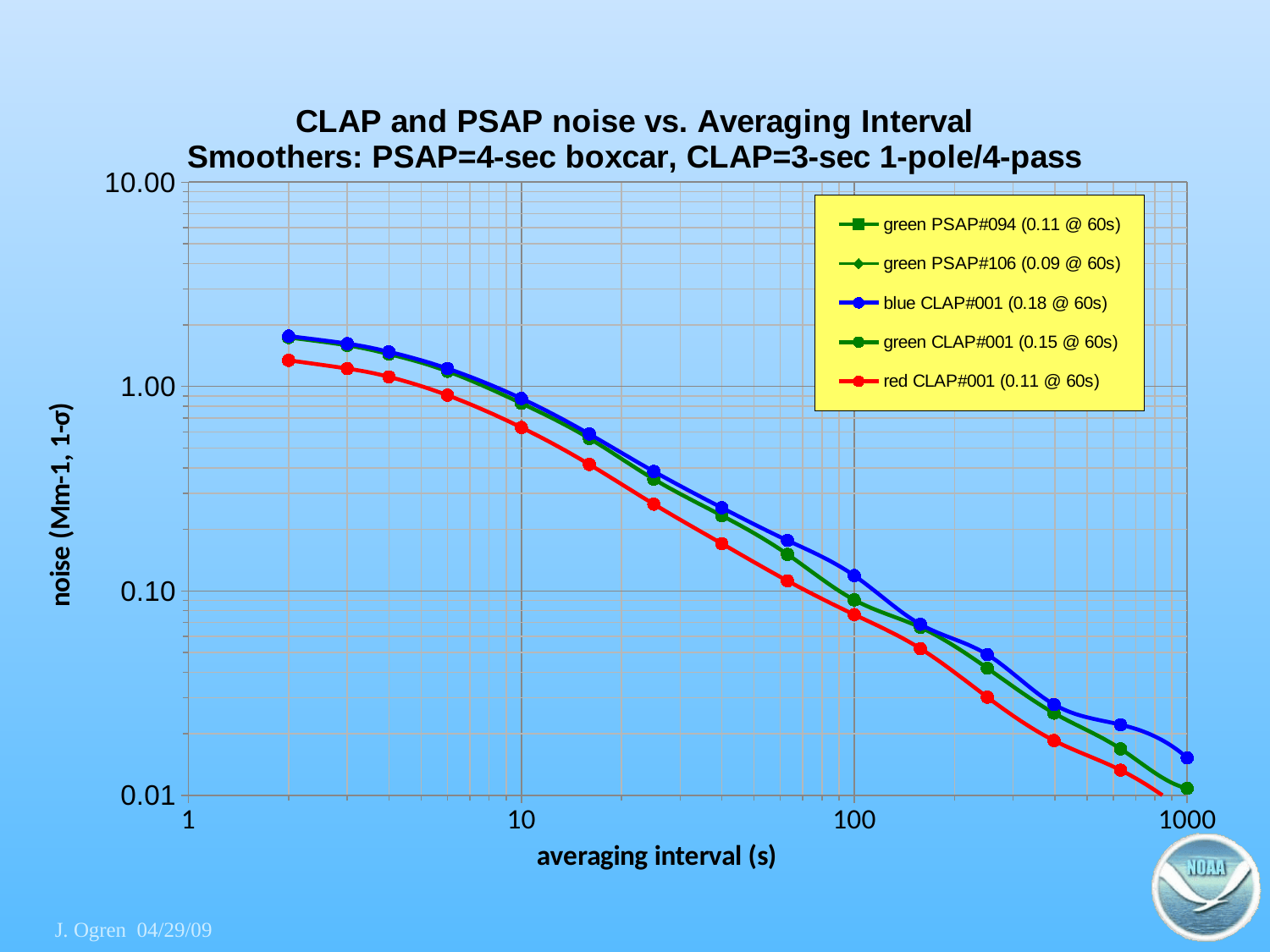
How many series does the legend list? 5 What kind of chart is shown on the slide? line chart According to the legend values at 60s, which series has the highest noise? blue CLAP#001 Is the noise value for the blue CLAP#001 line at an averaging interval of 100 s greater or less than 0.10? greater What is the label of the x axis? averaging interval (s) According to the legend, what is the noise value at 60s for green PSAP#106? 0.09 Using the legend values at 60s, what is the difference between blue CLAP#001 and red CLAP#001? 0.07 At an averaging interval of 100 s, which line has the larger noise value, the blue CLAP#001 line or the red CLAP#001 line? blue CLAP#001 According to the legend values at 60s, which series has the lowest noise? green PSAP#106 According to the legend, what is the noise value at 60s for blue CLAP#001? 0.18 Is the noise value for the red CLAP#001 line at an averaging interval of 10 s greater or less than 1.00? less Do the noise values rise or fall as the averaging interval increases? fall